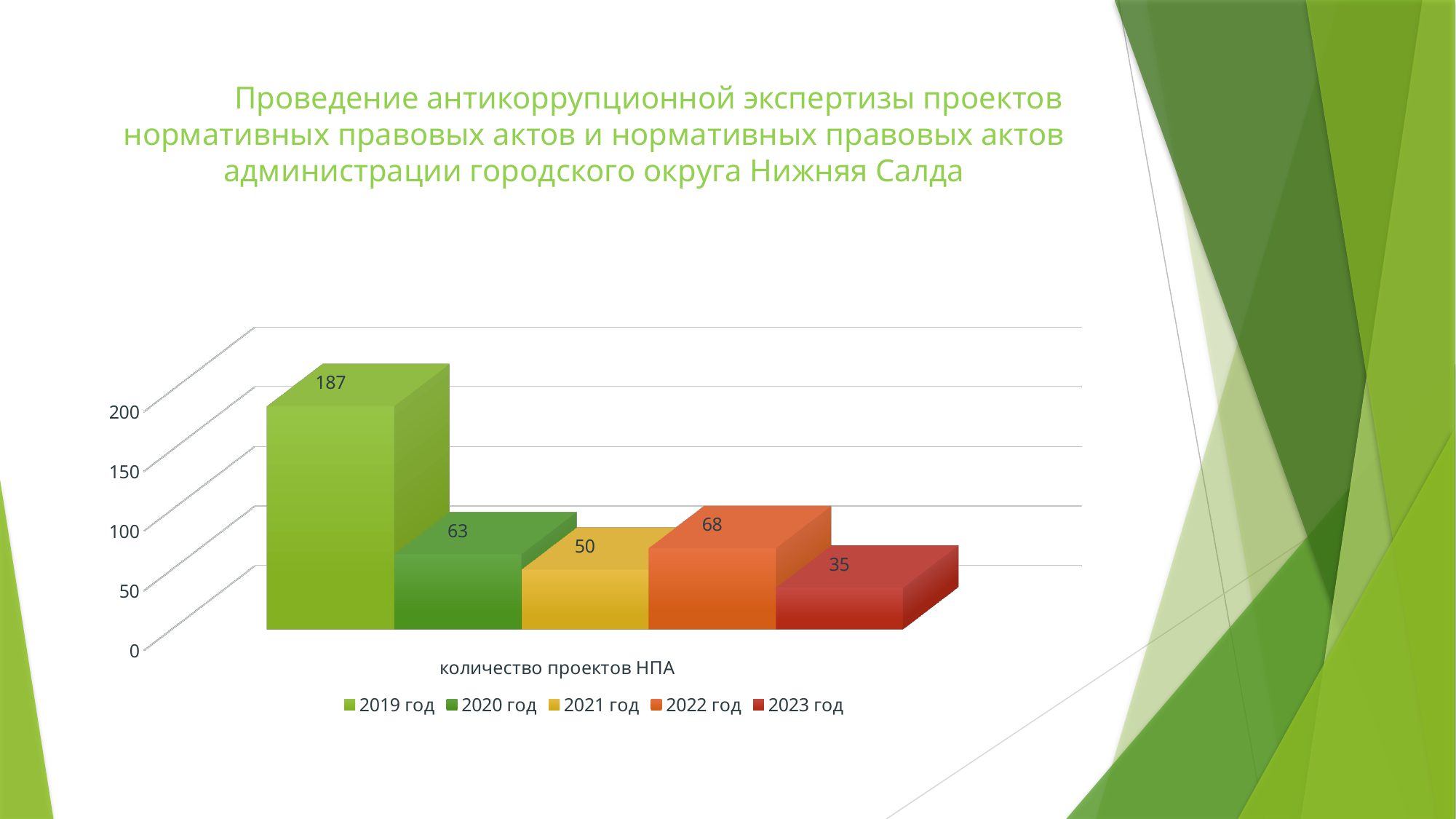
How many series does the legend list? 5 What colour is the bar for 2021 год? yellow Which is larger, the value for 2020 год or the value for 2022 год? 2022 год Which year has the lowest value? 2023 год What kind of chart is shown on the slide? bar chart What is the category label shown on the x axis? количество проектов НПА What is the difference between the values for 2019 год and 2020 год? 124 What is the value for 2023 год? 35 What is the value for 2021 год? 50 Which year has the highest value? 2019 год What is the difference between the values for 2022 год and 2023 год? 33 What is the value for 2019 год? 187